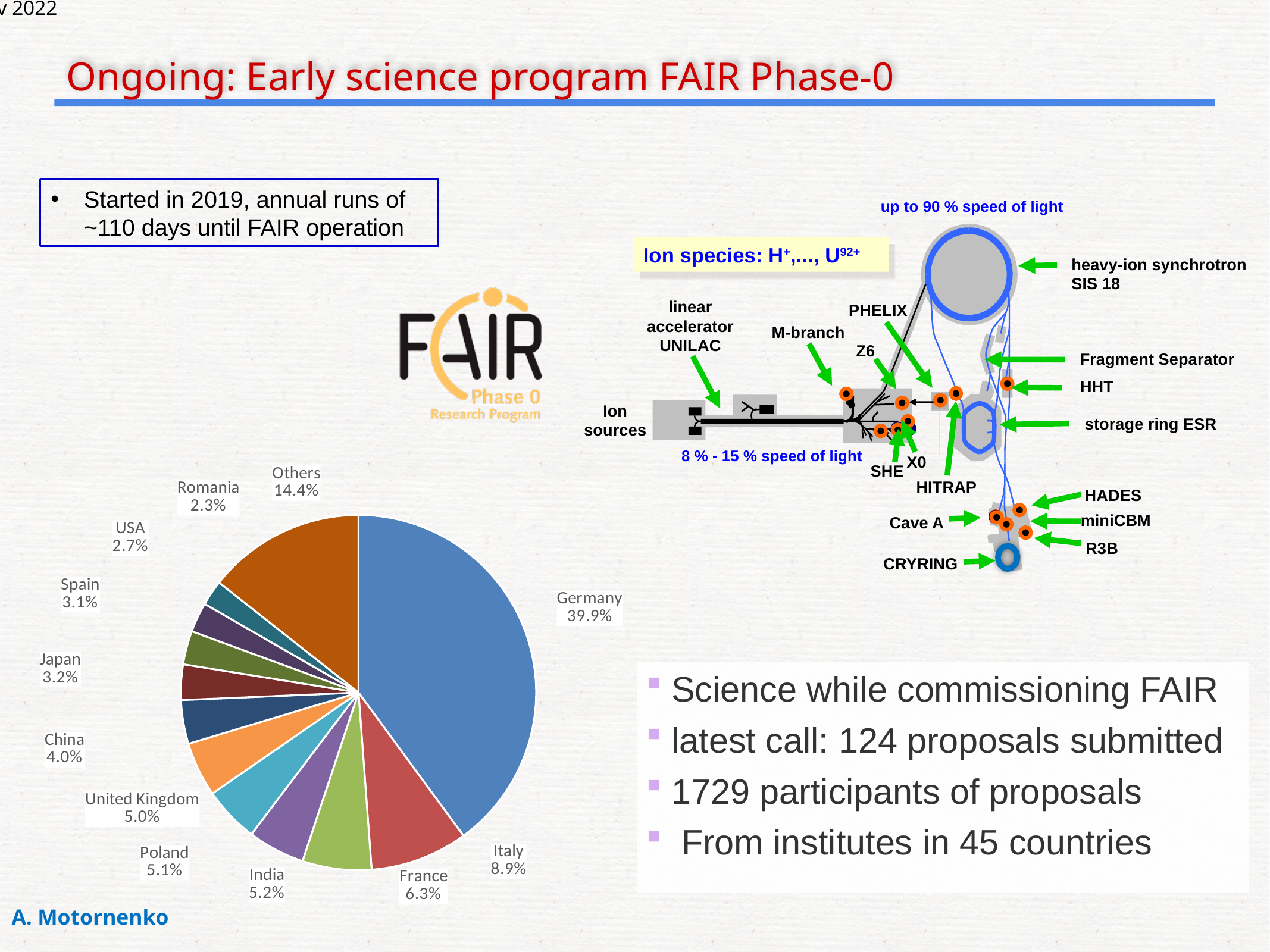
What is the difference in percentage points between Germany and Italy in the pie chart? 31.0 Which labelled slice of the pie chart is the smallest? Romania What percentage is shown for Italy in the pie chart? 8.9% What share of the pie chart does Germany account for? 39.9% Which country has the largest slice of the pie chart? Germany What percentage is shown for Romania in the pie chart? 2.3% What is the difference in percentage points between France and India in the pie chart? 1.1 How many slices does the pie chart have? 12 What type of chart is shown on the slide? Pie chart Which has a larger share in the pie chart, Others or Italy? Others Which has a larger share in the pie chart, China or Japan? China What percentage is shown for the United Kingdom in the pie chart? 5.0%